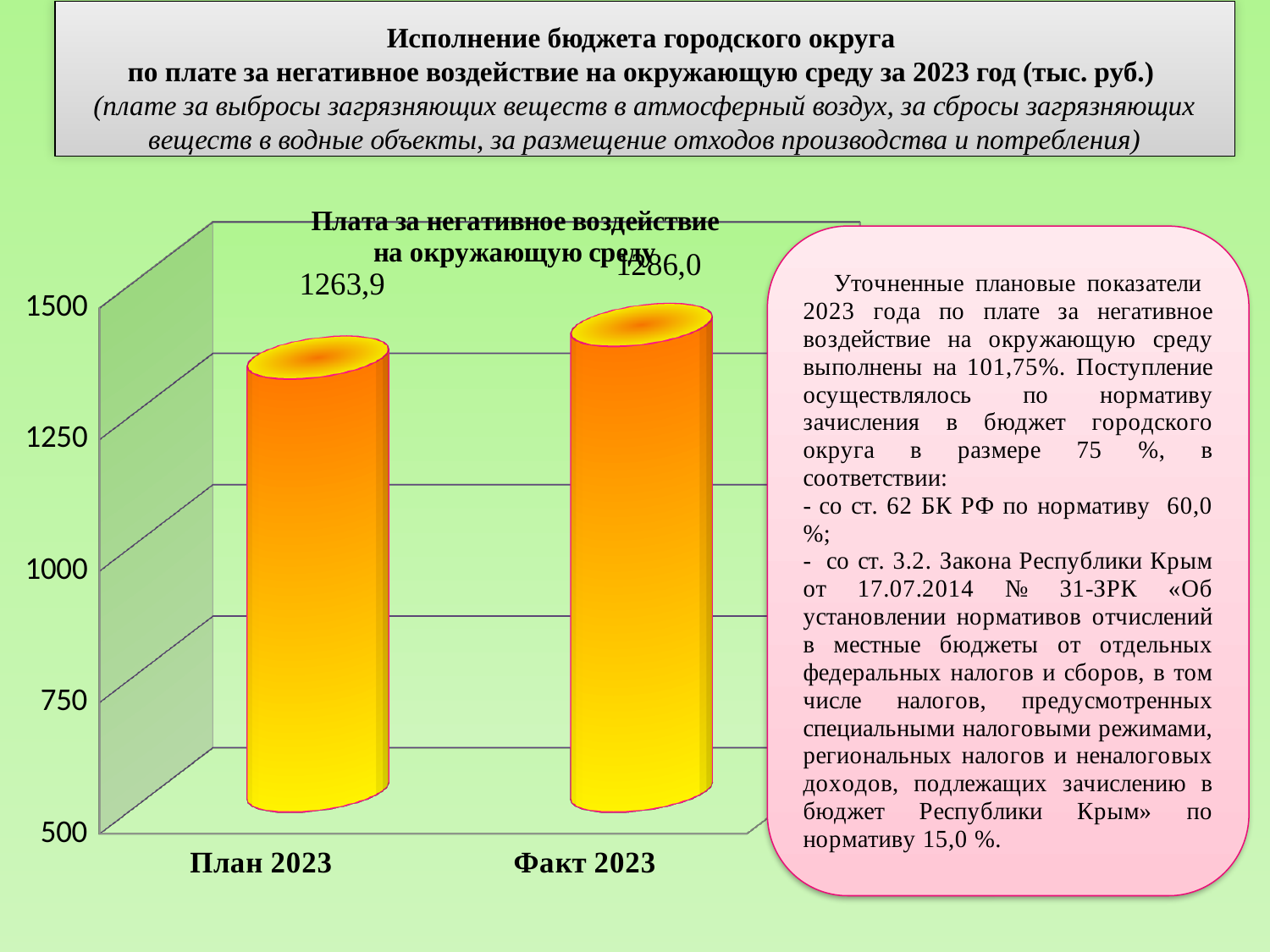
What kind of chart is shown on the slide? Bar chart Is the value for План 2023 larger than the value for Факт 2023? No How many categories are shown on the chart? 2 Do the values rise or fall from План 2023 to Факт 2023? Rise What is the difference between the values for Факт 2023 and План 2023? 22,1 What is the value for План 2023? 1263,9 What is the value for Факт 2023? 1286,0 Is the value for Факт 2023 greater or less than 1250? greater Which category has the higher value, План 2023 or Факт 2023? Факт 2023 What is the title of the chart? Плата за негативное воздействие на окружающую среду Which category has the lowest value? План 2023 Is the value for План 2023 greater or less than 1500? less